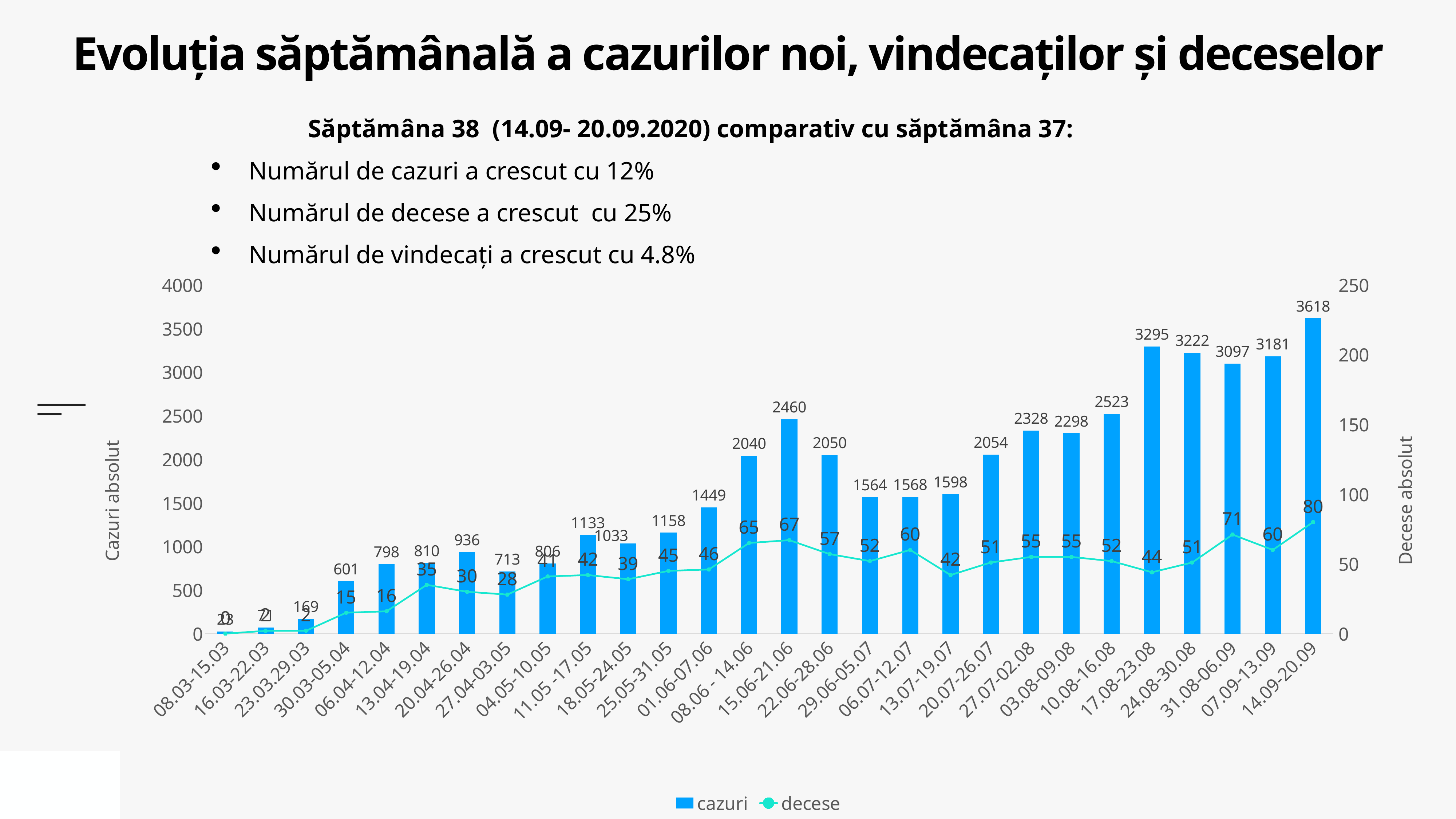
What is the difference in decese between the weeks 14.09-20.09 and 07.09-13.09? 20 What is the number of decese for the week 15.06-21.06? 67 Which week has more cazuri, 15.06-21.06 or 22.06-28.06? 15.06-21.06 What is the number of cazuri for the week 17.08-23.08? 3295 What is the difference in cazuri between the weeks 14.09-20.09 and 07.09-13.09? 437 How many series does the legend list? 2 What is the number of decese for the week 31.08-06.09? 71 How many weeks are shown on the x axis? 28 Which week has the highest number of cazuri? 14.09-20.09 Which week has the highest number of decese? 14.09-20.09 What is the number of cazuri for the week 14.09-20.09? 3618 Is the number of cazuri for the week 10.08-16.08 greater or less than 2000? greater